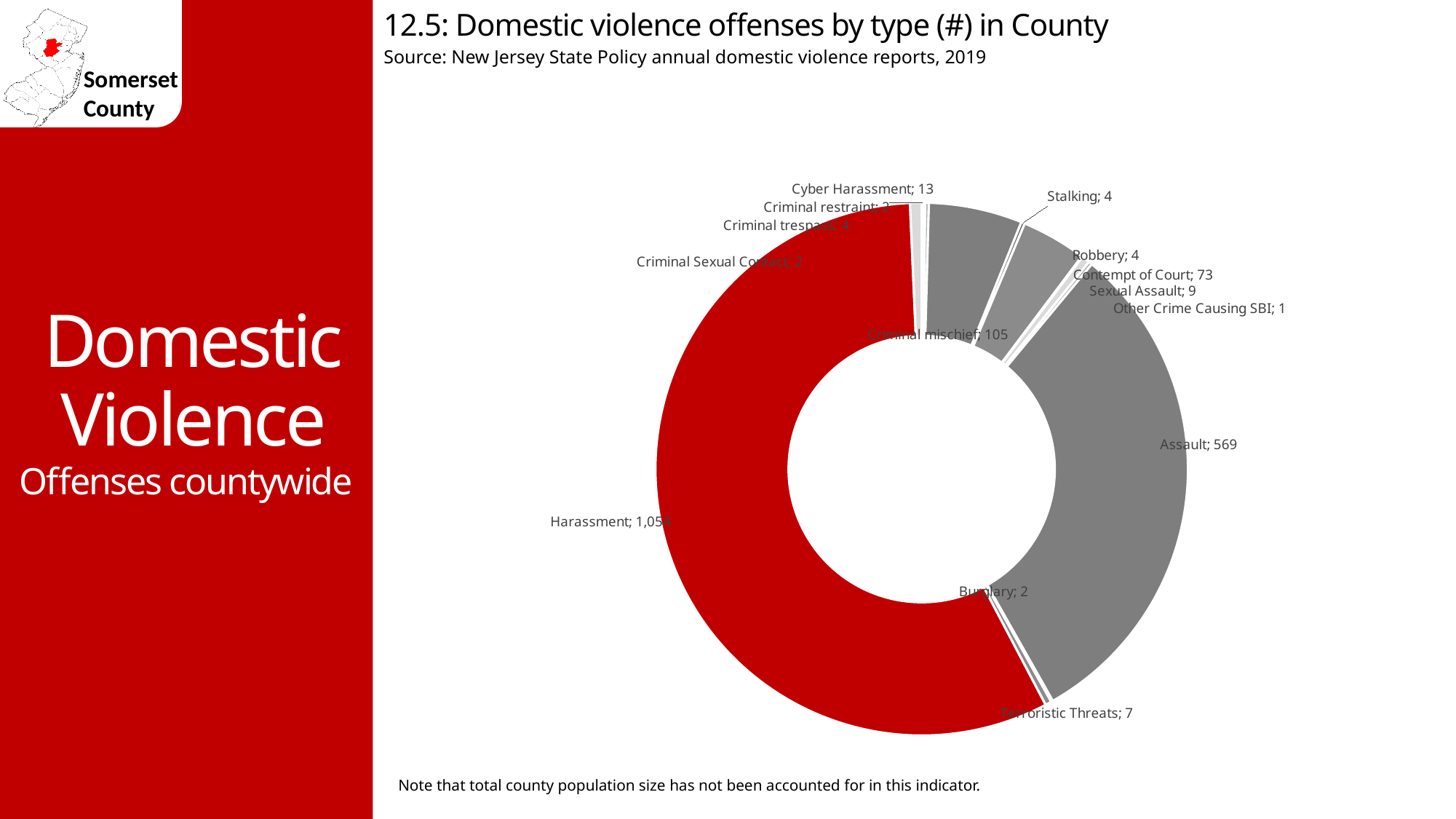
What value is shown for Cyber Harassment? 13 Which offense type has the lowest number of offenses? Other Crime Causing SBI What kind of chart is shown on the slide? Pie (donut) chart What is the title of the chart? 12.5: Domestic violence offenses by type (#) in County Which offense type has the highest number of offenses? Harassment How many Criminal mischief offenses are shown on the chart? 105 What is the number of Harassment offenses shown on the chart? 1,054 What value is shown for Contempt of Court? 73 What is the difference between the number of Harassment offenses and Assault offenses? 485 Which is larger, the number of Assault offenses or Criminal mischief offenses? Assault What is the difference between Criminal mischief and Contempt of Court offenses? 32 What is the number of Assault offenses shown on the chart? 569